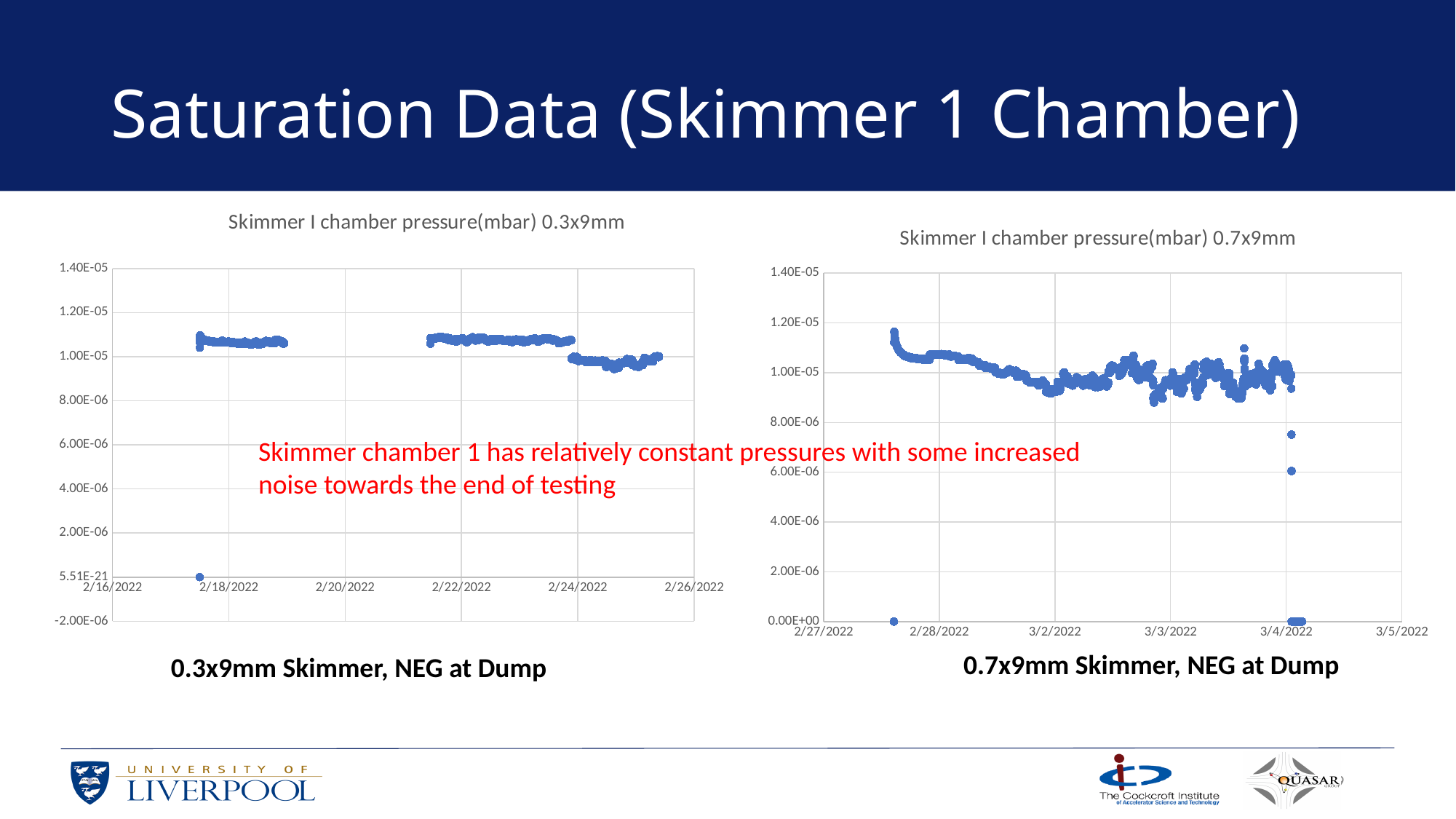
In the right chart (0.7x9mm), is the highest pressure value plotted near the start of the data (just before 2/28/2022) greater or less than 1.00E-05? greater What is the highest y-axis tick label shown on the left chart (0.3x9mm)? 1.40E-05 What is the last x-axis date label shown on the right chart (0.7x9mm)? 3/5/2022 What kind of chart is the right chart titled 'Skimmer I chamber pressure(mbar) 0.7x9mm'? Scatter chart What kind of chart is the left chart titled 'Skimmer I chamber pressure(mbar) 0.3x9mm'? Scatter chart In the right chart (0.7x9mm), are the pressure values plotted around 3/2/2022 greater or less than 1.20E-05? less In the left chart (0.3x9mm), are the pressure values plotted around 2/22/2022 greater or less than 1.20E-05? less How many charts are shown on the slide? 2 In the left chart (0.3x9mm), are the pressure values after 2/24/2022 higher or lower than those around 2/22/2022? lower In the right chart (0.7x9mm), do the pressure values generally rise or fall between 2/28/2022 and 3/2/2022? fall